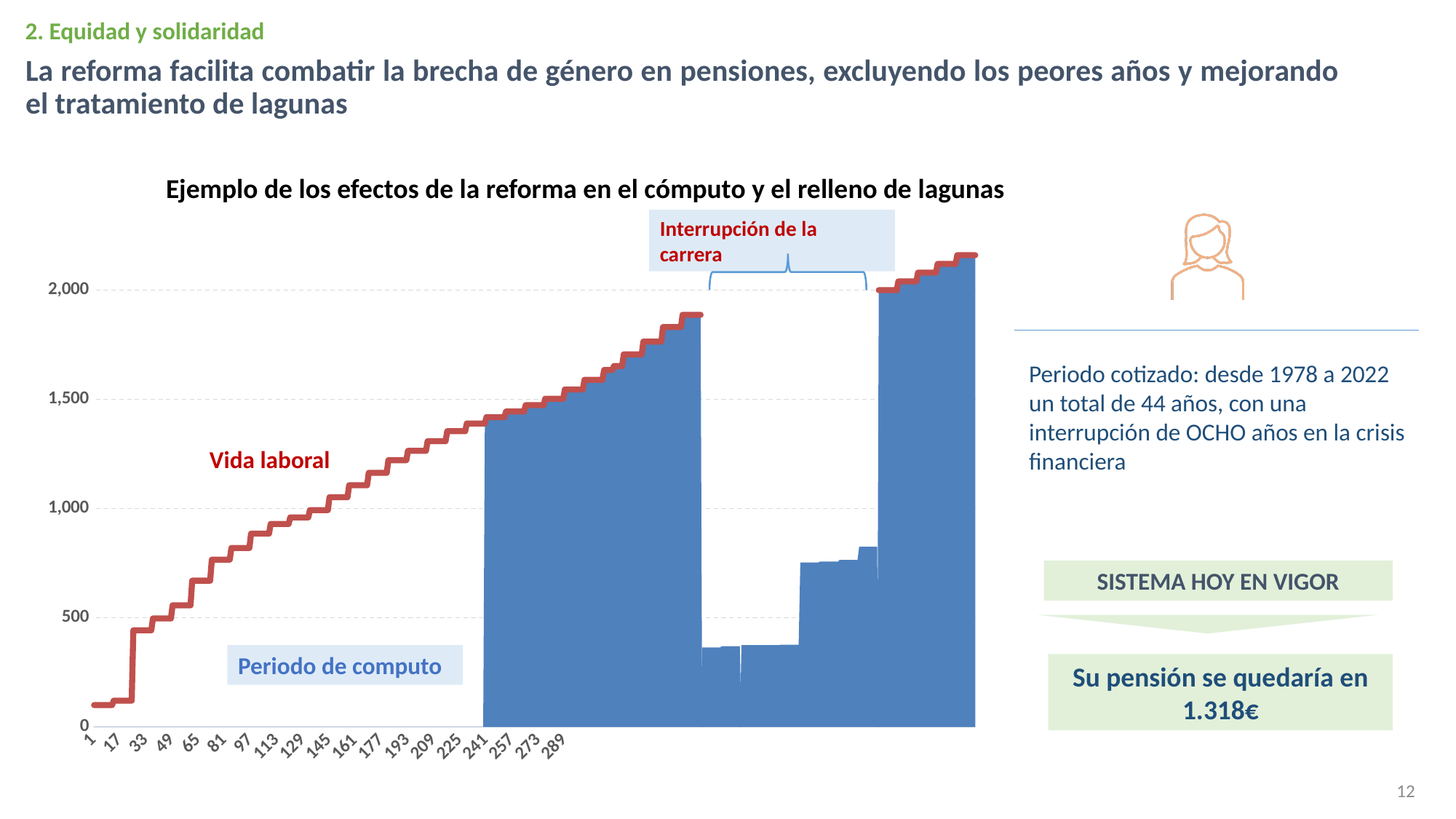
Is the value of the red line at x = 97 greater or less than 1,000? less What label is shown in red next to the red line in the chart? Vida laboral Is the value of the red line at its right-hand end greater or less than 2,000? greater Which is larger: the value of the red line at x = 33 or at x = 161? x = 161 What is the highest value labelled on the vertical axis? 2,000 What is the title of the chart? Ejemplo de los efectos de la reforma en el cómputo y el relleno de lagunas Is the value of the red line at x = 241 greater or less than 1,500? less How many labels are printed on the horizontal axis? 19 Does the red line generally rise or fall as x increases from 1 to 241? rise